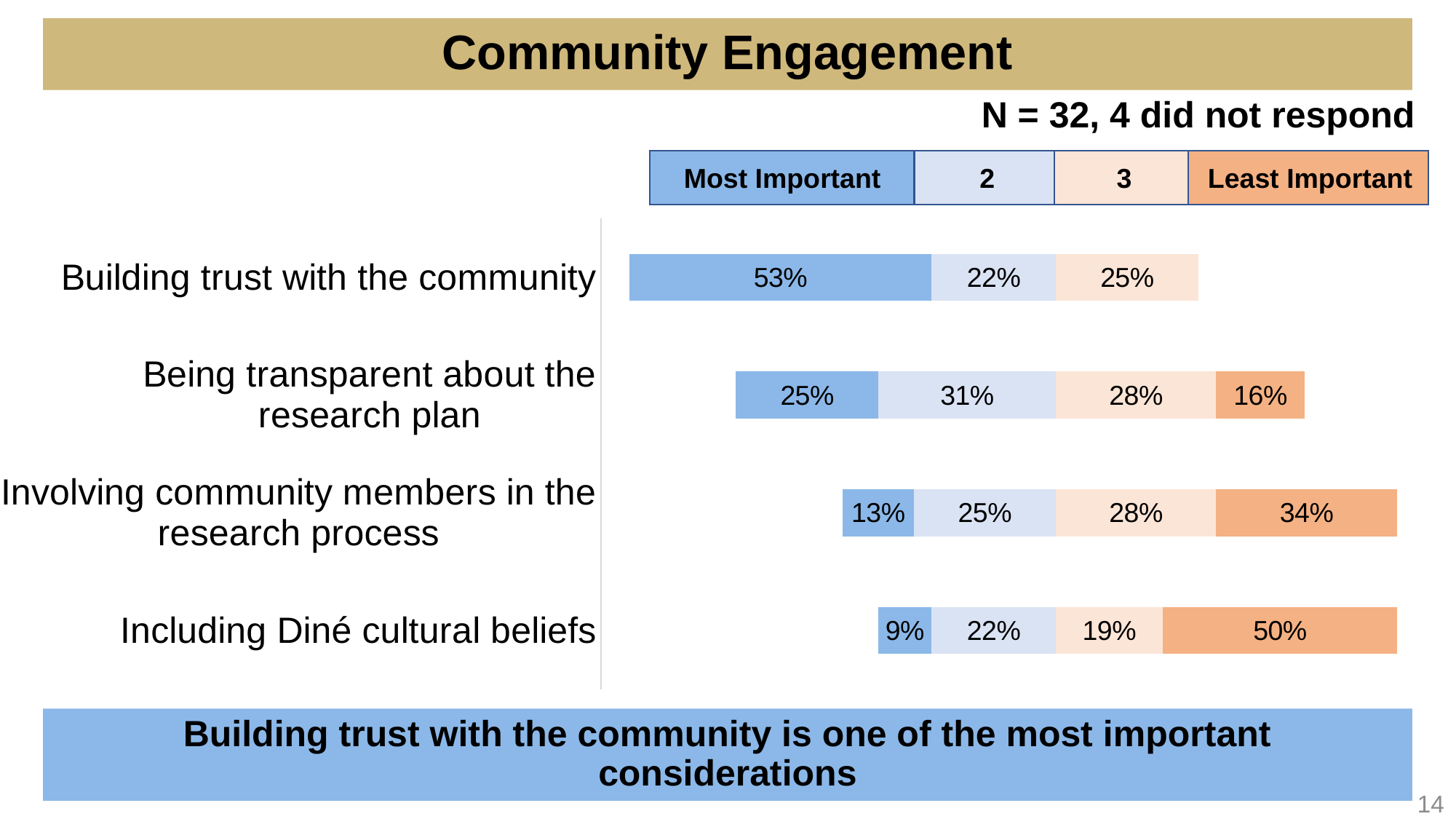
What percentage rated "Including Diné cultural beliefs" as Least Important? 50% What is the difference in the Most Important percentage between "Building trust with the community" and "Being transparent about the research plan"? 28 percentage points What is the value of the "3" segment for "Involving community members in the research process"? 28% Which category has the lowest Most Important percentage? Including Diné cultural beliefs What kind of chart is shown on the slide? Stacked bar chart Which category has the highest Most Important percentage? Building trust with the community What is the value of the "2" segment for "Being transparent about the research plan"? 31% How many series does the legend list? 4 Which has a larger Least Important percentage: "Involving community members in the research process" or "Being transparent about the research plan"? Involving community members in the research process How many categories are shown in the chart? 4 What percentage of respondents rated "Building trust with the community" as Most Important? 53% What is the title of the slide containing the chart? Community Engagement